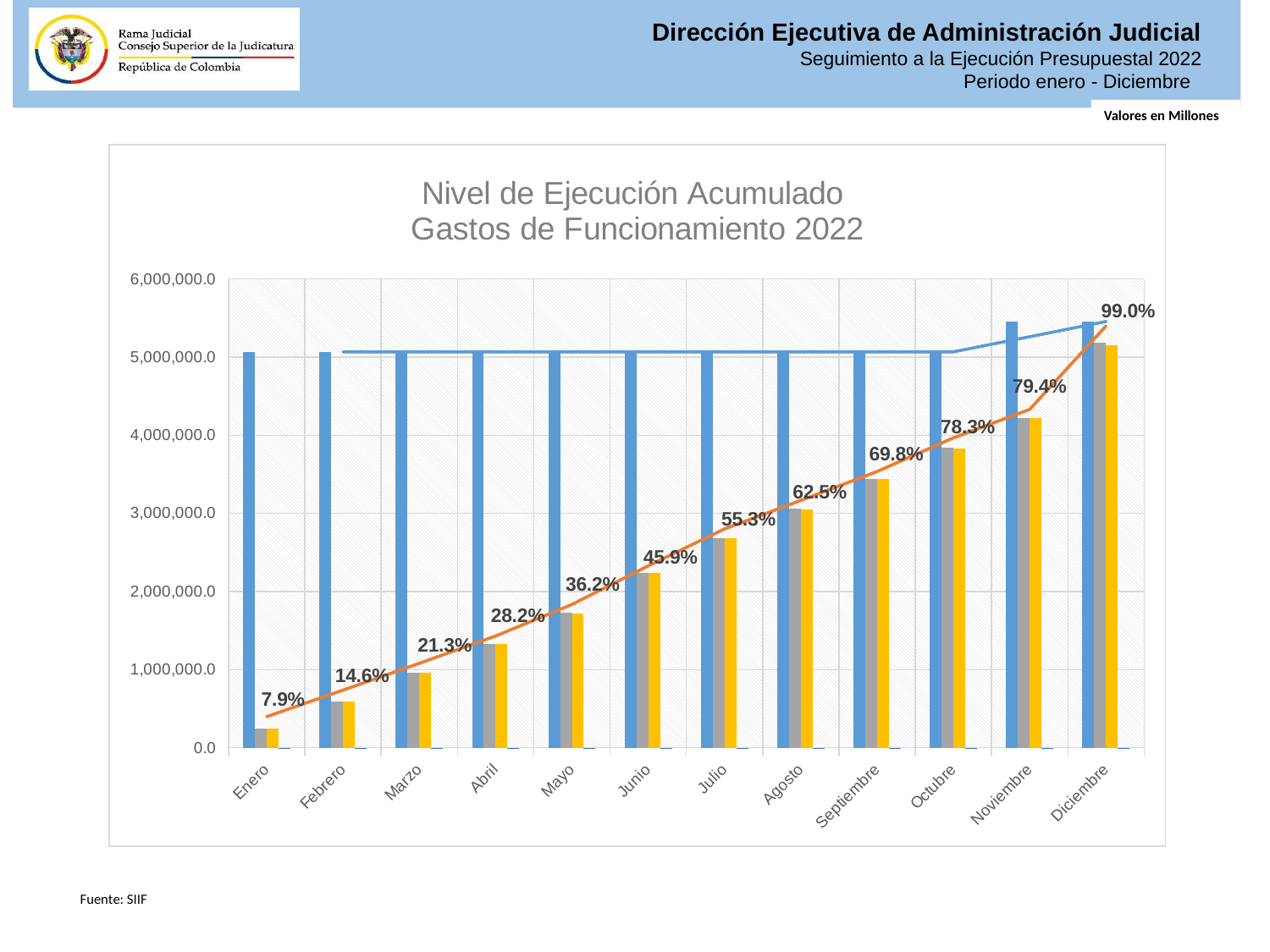
Which month has the highest cumulative execution percentage? Diciembre Which month has the lowest cumulative execution percentage? Enero How many months are shown on the x axis? 12 What cumulative execution percentage is shown for Diciembre? 99.0% What is the difference in percentage points between the cumulative execution in Diciembre and Noviembre? 19.6 What cumulative execution percentage is shown for Octubre? 78.3% Does the cumulative execution percentage rise or fall from Enero to Diciembre? rise Which month has a higher cumulative execution percentage, Agosto or Septiembre? Septiembre What cumulative execution percentage is shown for Enero? 7.9% What is the title of the chart? Nivel de Ejecución Acumulado Gastos de Funcionamiento 2022 What cumulative execution percentage is shown for Junio? 45.9%